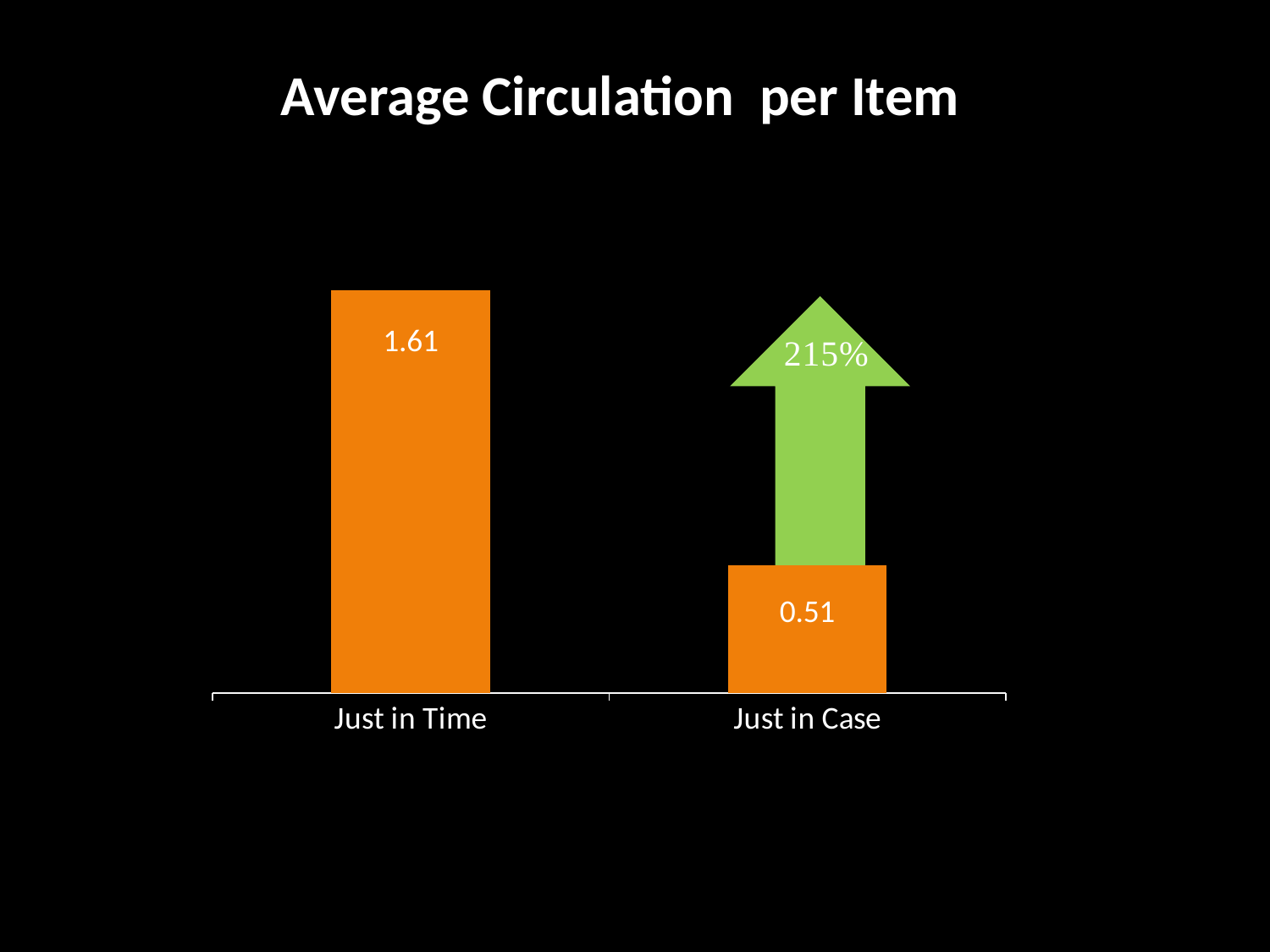
What is the average circulation per item for Just in Time? 1.61 What is the average circulation per item for Just in Case? 0.51 Which category has the highest average circulation per item? Just in Time What is the difference between the Just in Time and Just in Case values? 1.10 Which is larger, the value for Just in Time or the value for Just in Case? Just in Time What is the title of the chart? Average Circulation per Item Do the values rise or fall from Just in Time to Just in Case? Fall Which category has the lowest average circulation per item? Just in Case What percentage is printed on the green arrow above the Just in Case bar? 215% How many categories are shown on the chart? 2 What kind of chart is shown on the slide? Bar chart